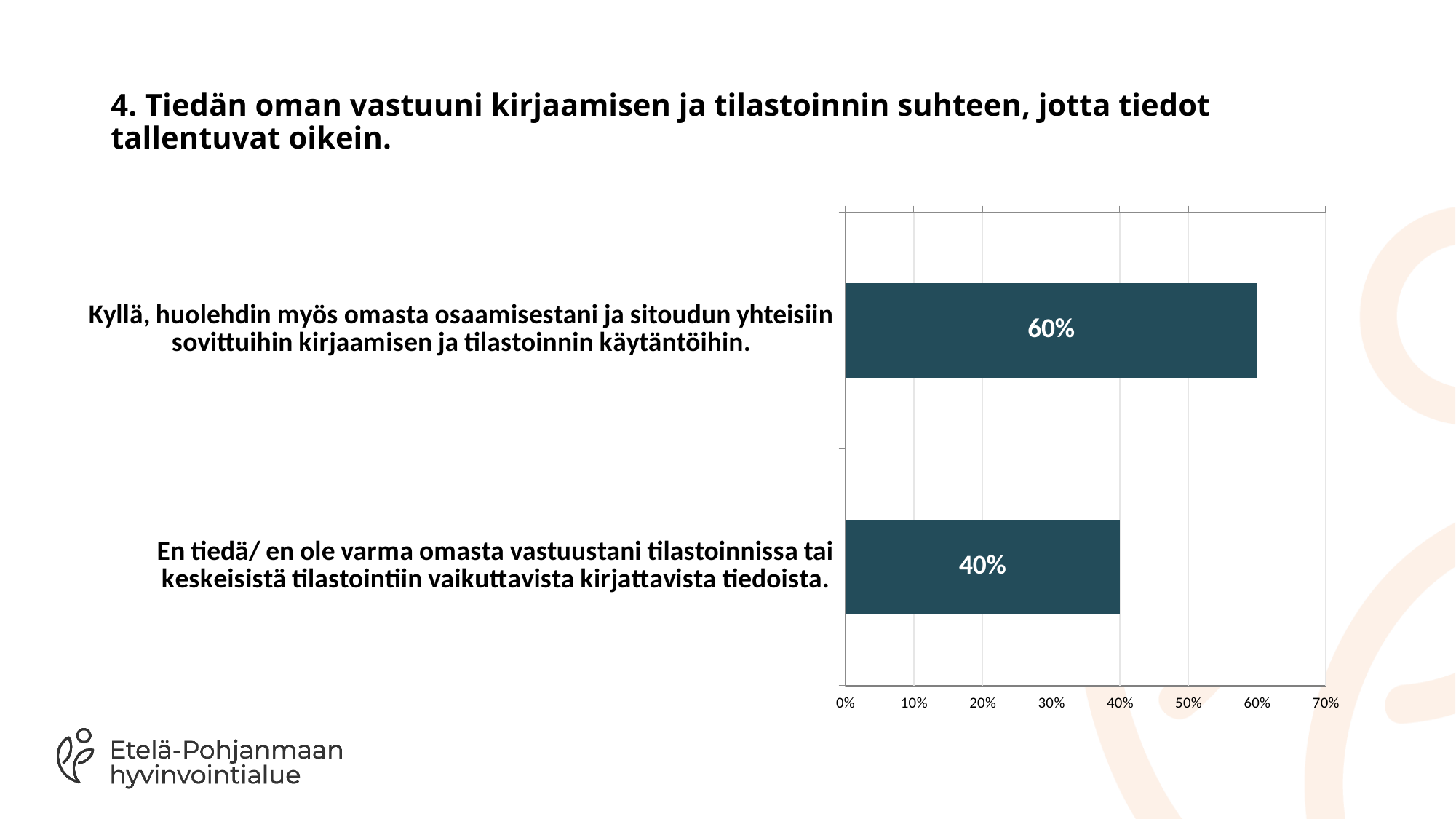
Which category has the lowest value? En tiedä/ en ole varma omasta vastuustani tilastoinnissa tai keskeisistä tilastointiin vaikuttavista kirjattavista tiedoista. What is the maximum value shown on the x axis of the chart? 70% Which is larger: the value for the "Kyllä" category or the value for the "En tiedä" category? Kyllä, huolehdin myös omasta osaamisestani ja sitoudun yhteisiin sovittuihin kirjaamisen ja tilastoinnin käytäntöihin. Which category has the highest value? Kyllä, huolehdin myös omasta osaamisestani ja sitoudun yhteisiin sovittuihin kirjaamisen ja tilastoinnin käytäntöihin. What is the difference between the "Kyllä" category value and the "En tiedä" category value? 20% Is the value for the "Kyllä" category greater or less than 50%? greater What is the value for the category "Kyllä, huolehdin myös omasta osaamisestani ja sitoudun yhteisiin sovittuihin kirjaamisen ja tilastoinnin käytäntöihin."? 60% What is the total of the two category values shown in the chart? 100% Is the value for the "En tiedä" category greater or less than 50%? less How many categories are shown in the chart? 2 What kind of chart is shown on the slide? bar chart What is the value for the category "En tiedä/ en ole varma omasta vastuustani tilastoinnissa tai keskeisistä tilastointiin vaikuttavista kirjattavista tiedoista."? 40%